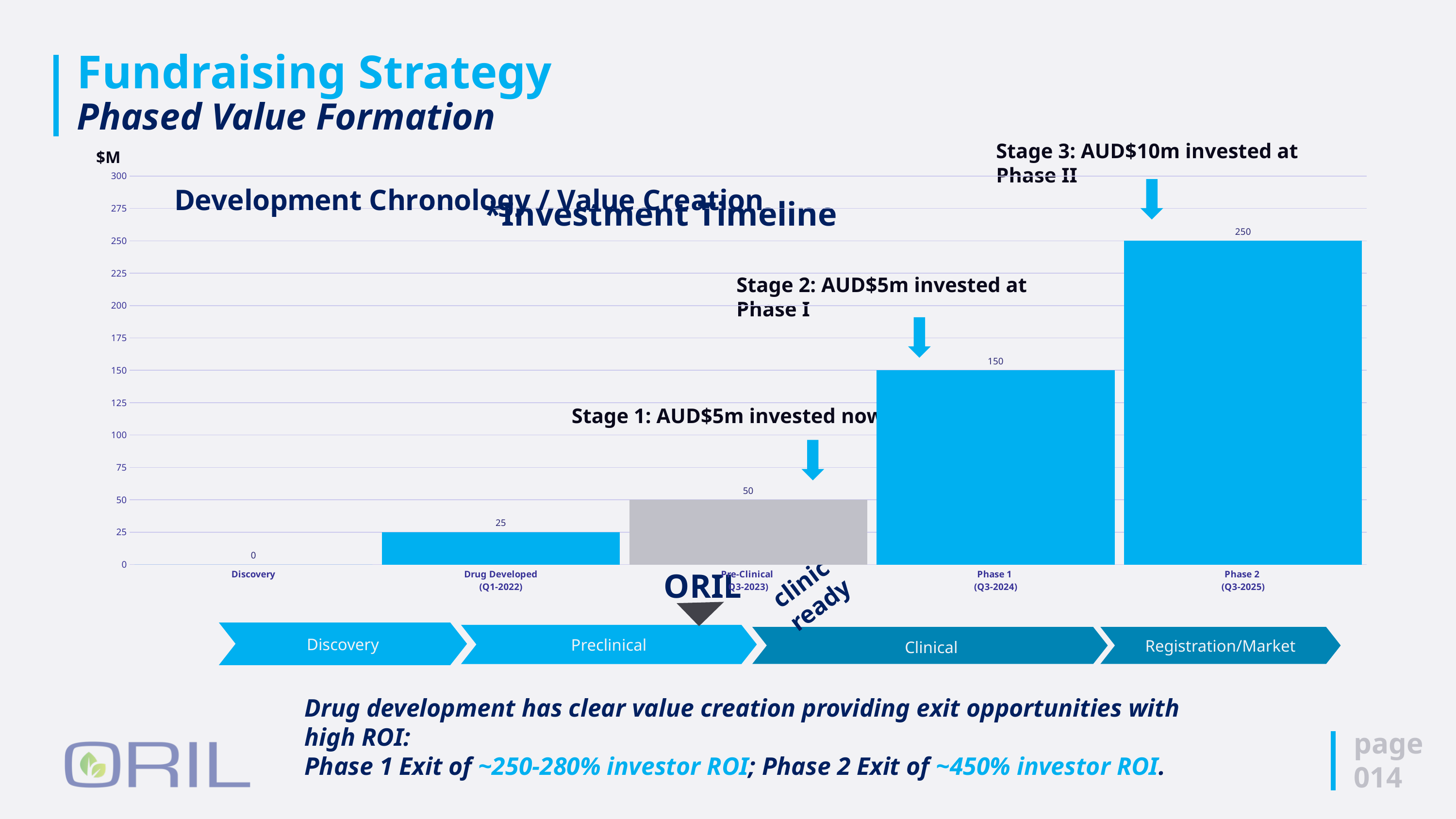
What is the value for Phase 2 (Q3-2025)? 250 What kind of chart is shown on the slide? Bar chart What unit is shown at the top of the y axis? $M How many categories are shown on the x axis of the chart? 5 What is the value for Phase 1 (Q3-2024)? 150 Which is larger, the value for Pre-Clinical (Q3-2023) or Drug Developed (Q1-2022)? Pre-Clinical (Q3-2023) What is the value for Pre-Clinical (Q3-2023)? 50 What is the value for Drug Developed (Q1-2022)? 25 Do the values rise or fall from Discovery to Phase 2 (Q3-2025)? Rise Which category has the lowest value? Discovery What is the difference between the values for Phase 2 (Q3-2025) and Phase 1 (Q3-2024)? 100 Which category has the highest value? Phase 2 (Q3-2025)